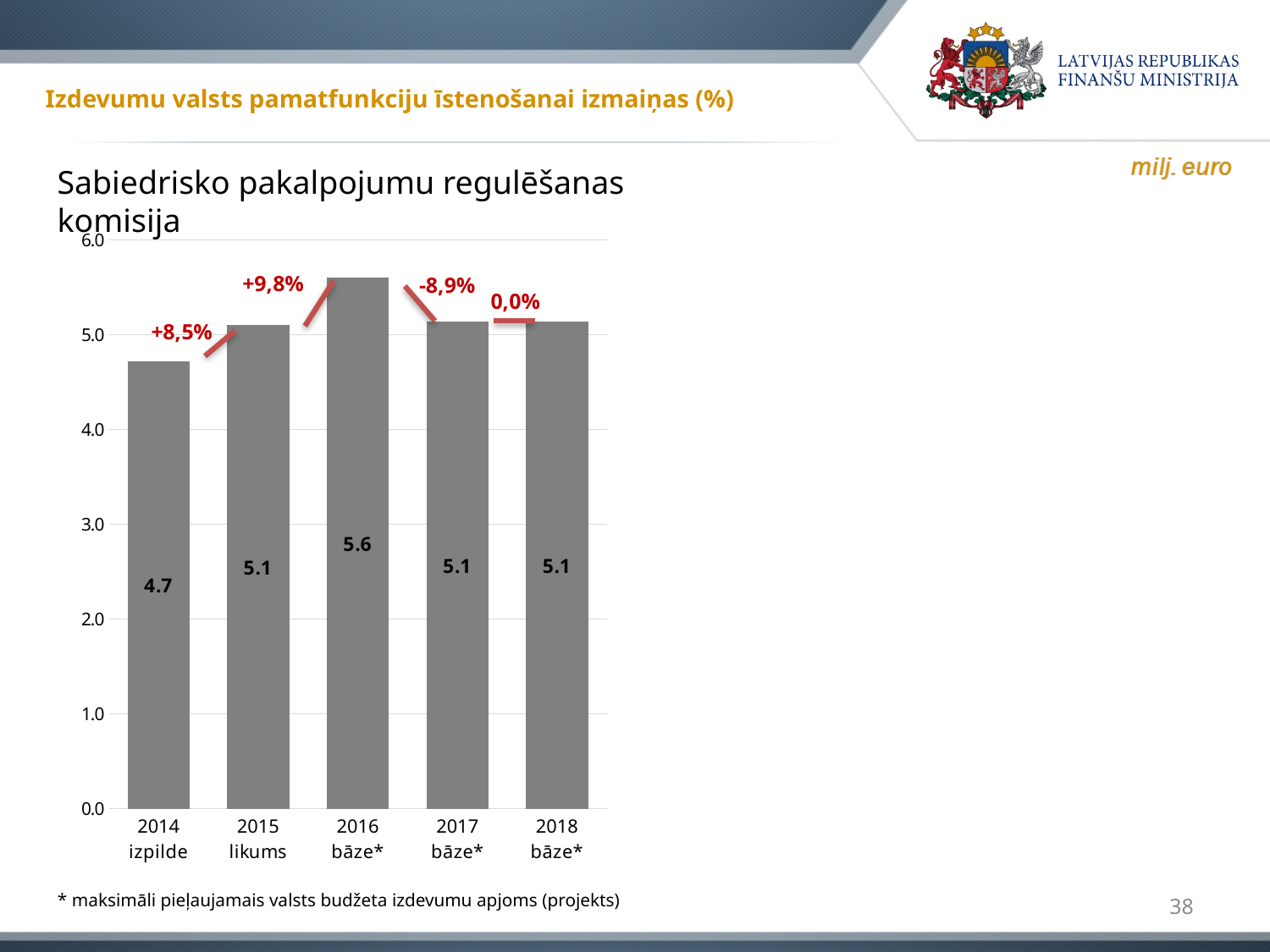
What is the value for 2018 bāze*? 5.1 Is the value for 2014 izpilde greater or less than 5.0? less What kind of chart is shown on the slide? bar chart How many bars are shown in the chart? 5 What is the value for 2014 izpilde? 4.7 Which category has the highest value? 2016 bāze* What percentage change is shown between 2015 likums and 2016 bāze*? +9,8% Which is larger, the value for 2014 izpilde or 2015 likums? 2015 likums What is the difference between the values for 2016 bāze* and 2014 izpilde? 0.9 What is the value for 2016 bāze*? 5.6 What is the title of the chart? Sabiedrisko pakalpojumu regulēšanas komisija Which category has the lowest value? 2014 izpilde